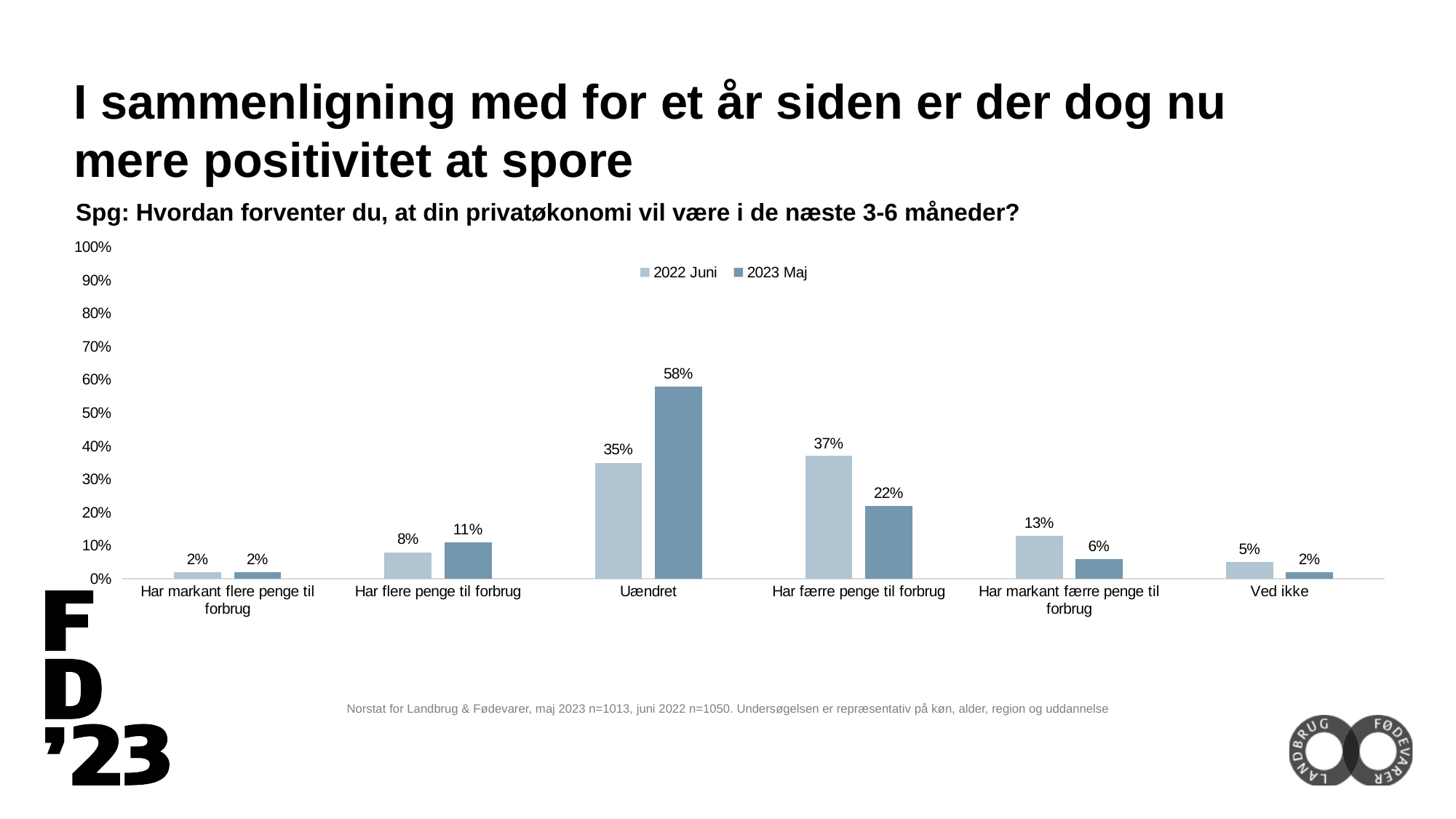
How many series does the legend list? 2 Which category has the lowest value in the 2022 Juni series? Har markant flere penge til forbrug What is the value for "Uændret" in the 2023 Maj series? 58% What are the two series named in the legend? 2022 Juni and 2023 Maj What is the value for "Har flere penge til forbrug" in the 2023 Maj series? 11% Which category has the highest value in the 2023 Maj series? Uændret How many categories are shown on the x axis? 6 What kind of chart is shown on the slide? Bar chart What is the value for "Har færre penge til forbrug" in the 2022 Juni series? 37% Which is larger for "Har markant færre penge til forbrug": the 2022 Juni value or the 2023 Maj value? 2022 Juni What is the difference between the 2023 Maj and 2022 Juni values for "Uændret"? 23 percentage points What is the difference between the 2022 Juni and 2023 Maj values for "Har færre penge til forbrug"? 15 percentage points